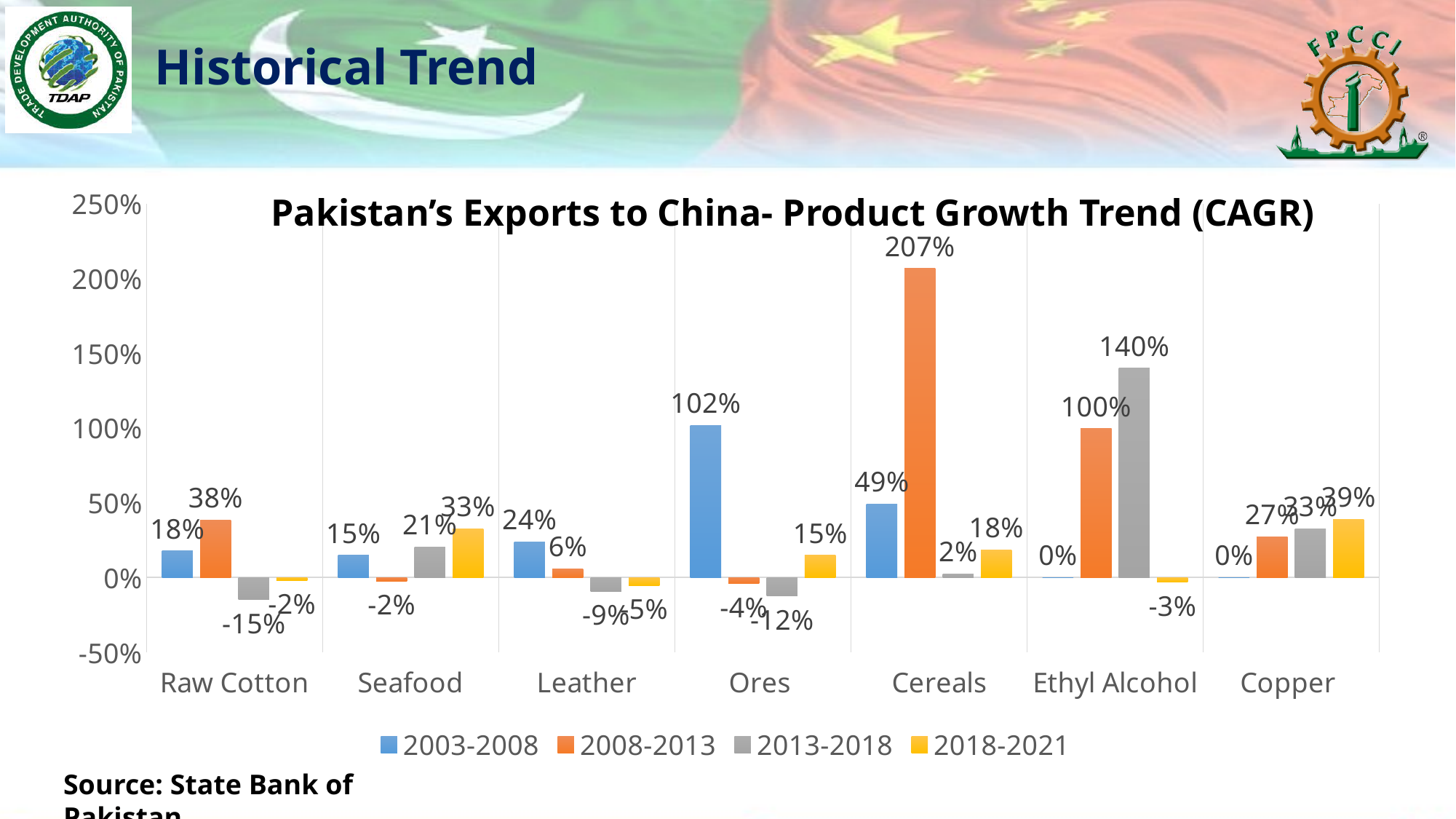
What is the title of the chart? Pakistan's Exports to China- Product Growth Trend (CAGR) Which is larger: Raw Cotton's 2008-2013 CAGR or Seafood's 2018-2021 CAGR? Raw Cotton's 2008-2013 CAGR What is the difference between Ethyl Alcohol's 2013-2018 CAGR and its 2008-2013 CAGR? 40% Which product has the highest CAGR in the 2008-2013 period? Cereals What is the CAGR value for Cereals in the 2008-2013 period? 207% What kind of chart is shown on the slide? Bar chart How many product categories are shown on the x axis? 7 What is the CAGR value for Ores in the 2003-2008 period? 102% Is the 2003-2008 value for Ores greater or less than 100%? greater Which product has the lowest CAGR in the 2013-2018 period? Raw Cotton How many series does the legend list? 4 What is the CAGR value for Ethyl Alcohol in the 2013-2018 period? 140%